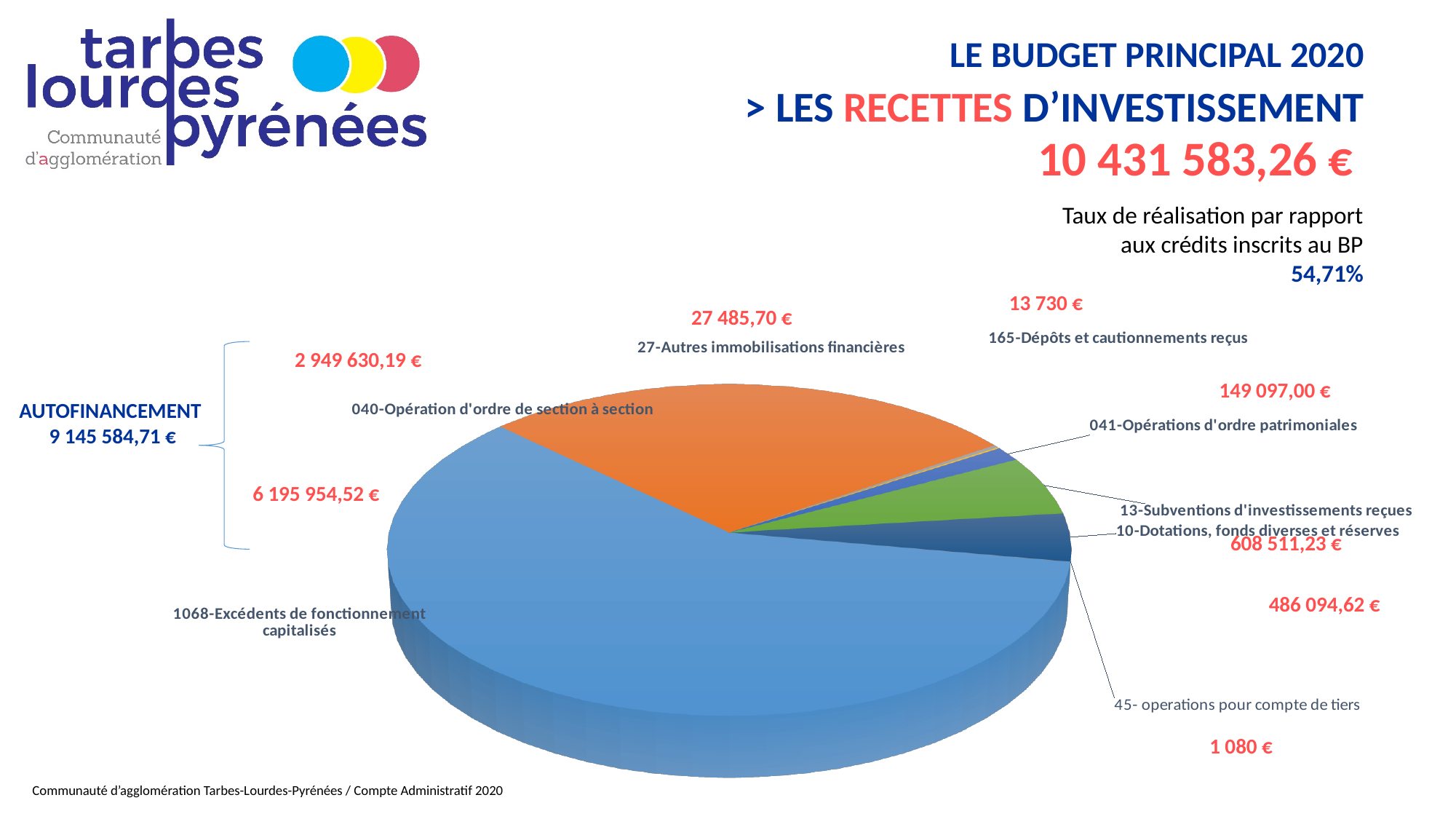
What is the difference between 1068-Excédents de fonctionnement capitalisés and 040-Opération d'ordre de section à section? 3 246 324,33 € What is the value for 27-Autres immobilisations financières? 27 485,70 € What kind of chart is shown on the slide? pie chart What is the value for 041-Opérations d'ordre patrimoniales? 149 097,00 € What total amount of recettes d'investissement is shown on the slide? 10 431 583,26 € How many categories (slices) does the pie chart show? 8 What is the value for 1068-Excédents de fonctionnement capitalisés? 6 195 954,52 € Which is larger: 27-Autres immobilisations financières or 165-Dépôts et cautionnements reçus? 27-Autres immobilisations financières What is the value for 165-Dépôts et cautionnements reçus? 13 730 € Which category has the smallest value in the pie chart? 45- operations pour compte de tiers Which category has the largest slice of the pie chart? 1068-Excédents de fonctionnement capitalisés What is the value for 040-Opération d'ordre de section à section? 2 949 630,19 €